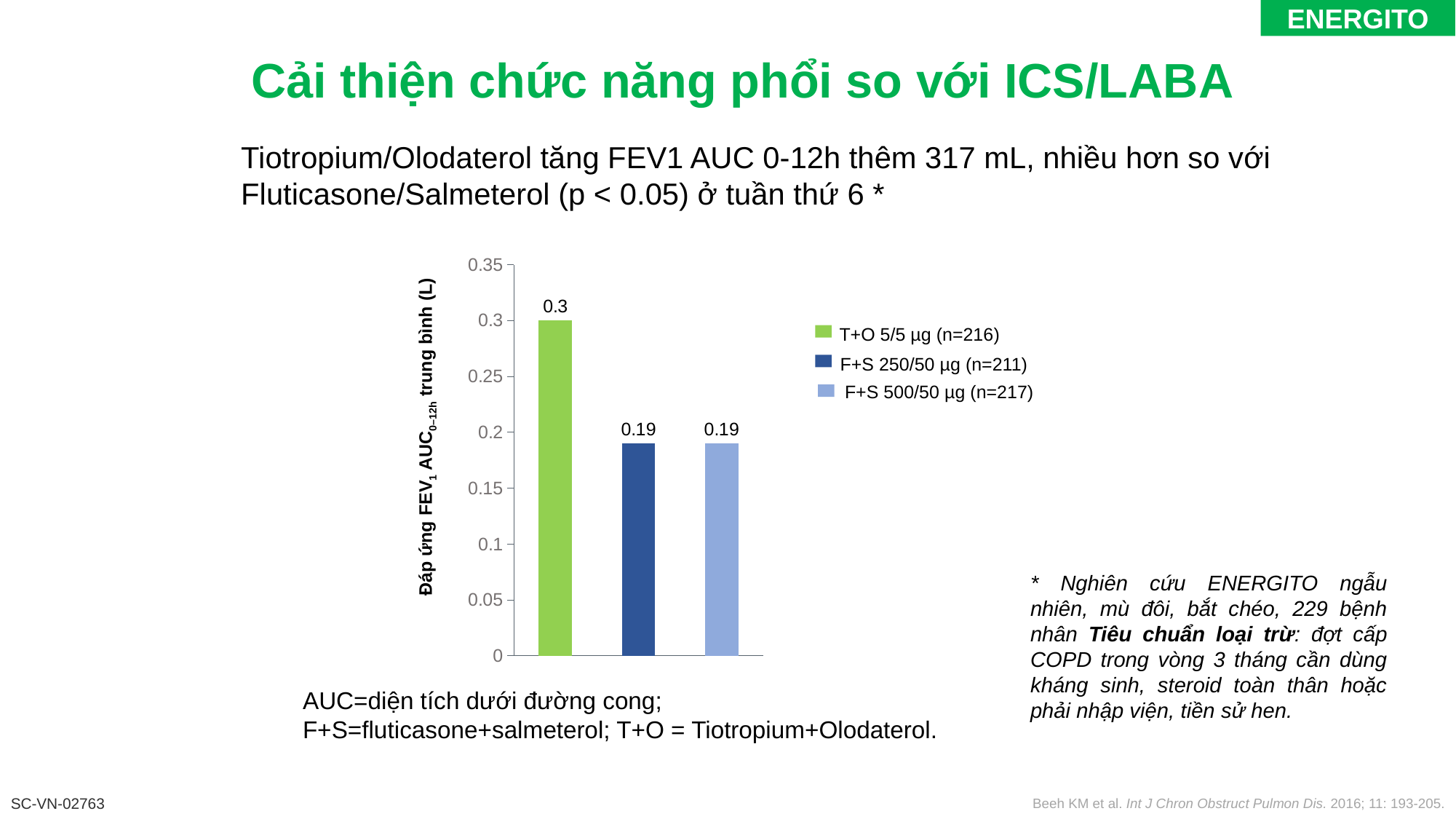
Which group has the highest mean FEV1 AUC0-12h response? T+O 5/5 µg (n=216) Which is larger, the value for T+O 5/5 µg or the value for F+S 500/50 µg? T+O 5/5 µg How many series does the legend list? 3 What kind of chart is shown on the slide? bar chart What is the difference between the values for T+O 5/5 µg and F+S 250/50 µg? 0.11 Is the value for F+S 250/50 µg greater or less than 0.25? less What is the value for F+S 500/50 µg (n=217)? 0.19 What is the value for F+S 250/50 µg (n=211)? 0.19 What is the value for T+O 5/5 µg (n=216)? 0.3 How many bars are plotted in the chart? 3 Is the value for T+O 5/5 µg greater or less than 0.25? greater What is the label of the y axis? Đáp ứng FEV1 AUC0-12h trung bình (L)